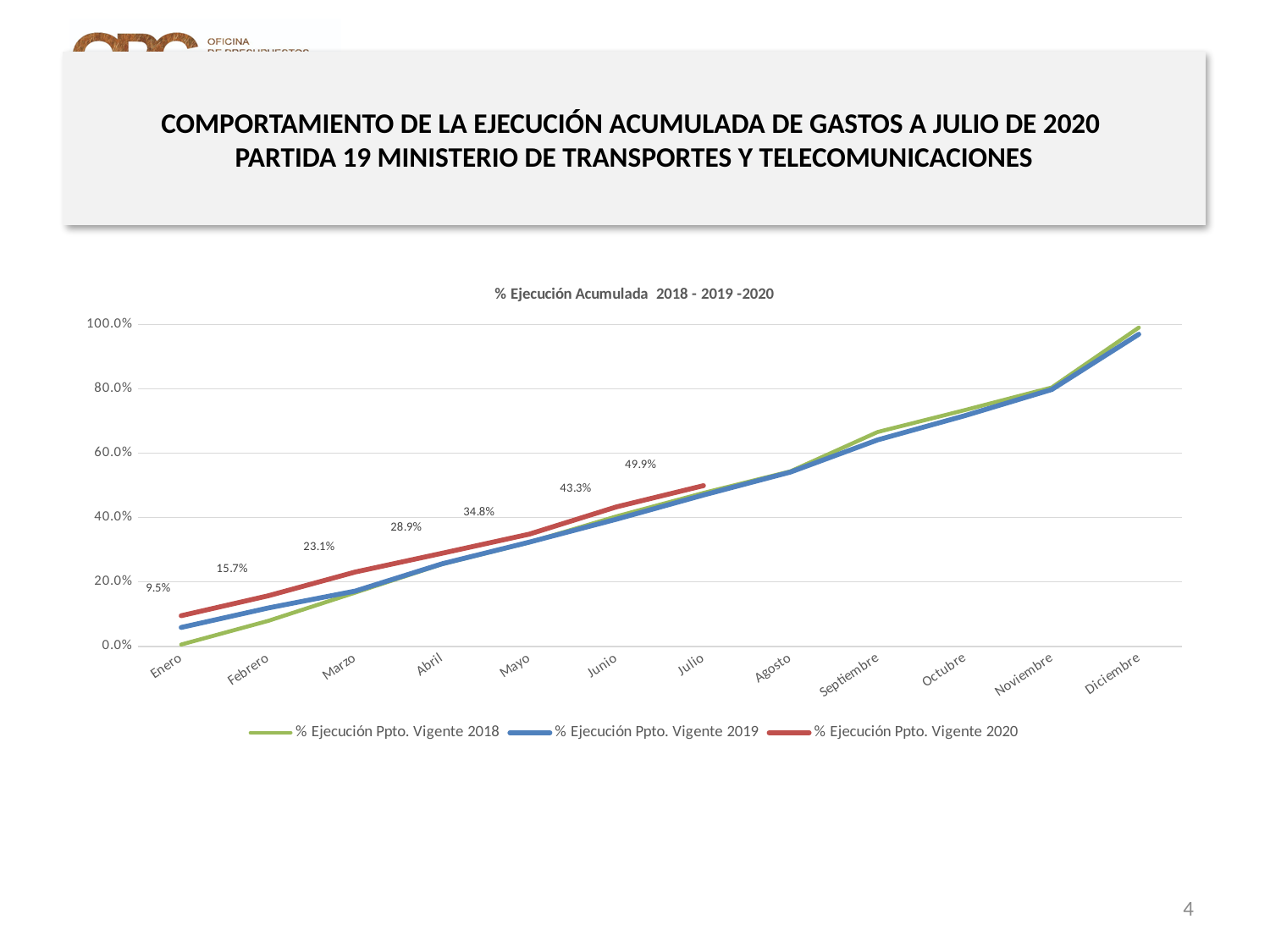
How many series does the legend list? 3 What is the value for Julio in the % Ejecución Ppto. Vigente 2020 series? 49.9% What is the difference between the Junio and Mayo values of the % Ejecución Ppto. Vigente 2020 series? 8.5% Which month has the lowest value in the % Ejecución Ppto. Vigente 2020 series? Enero What is the value for Abril in the % Ejecución Ppto. Vigente 2020 series? 28.9% Is the value for Diciembre in the % Ejecución Ppto. Vigente 2019 series greater or less than 80.0%? greater What is the difference between the Julio and Enero values of the % Ejecución Ppto. Vigente 2020 series? 40.4% Which month has the highest value in the % Ejecución Ppto. Vigente 2020 series? Julio What kind of chart is shown on the slide? Line chart Is the value for Enero in the % Ejecución Ppto. Vigente 2018 series greater or less than 20.0%? less What is the value for Enero in the % Ejecución Ppto. Vigente 2020 series? 9.5% Do the values of the % Ejecución Ppto. Vigente 2020 series rise or fall from Enero to Julio? Rise